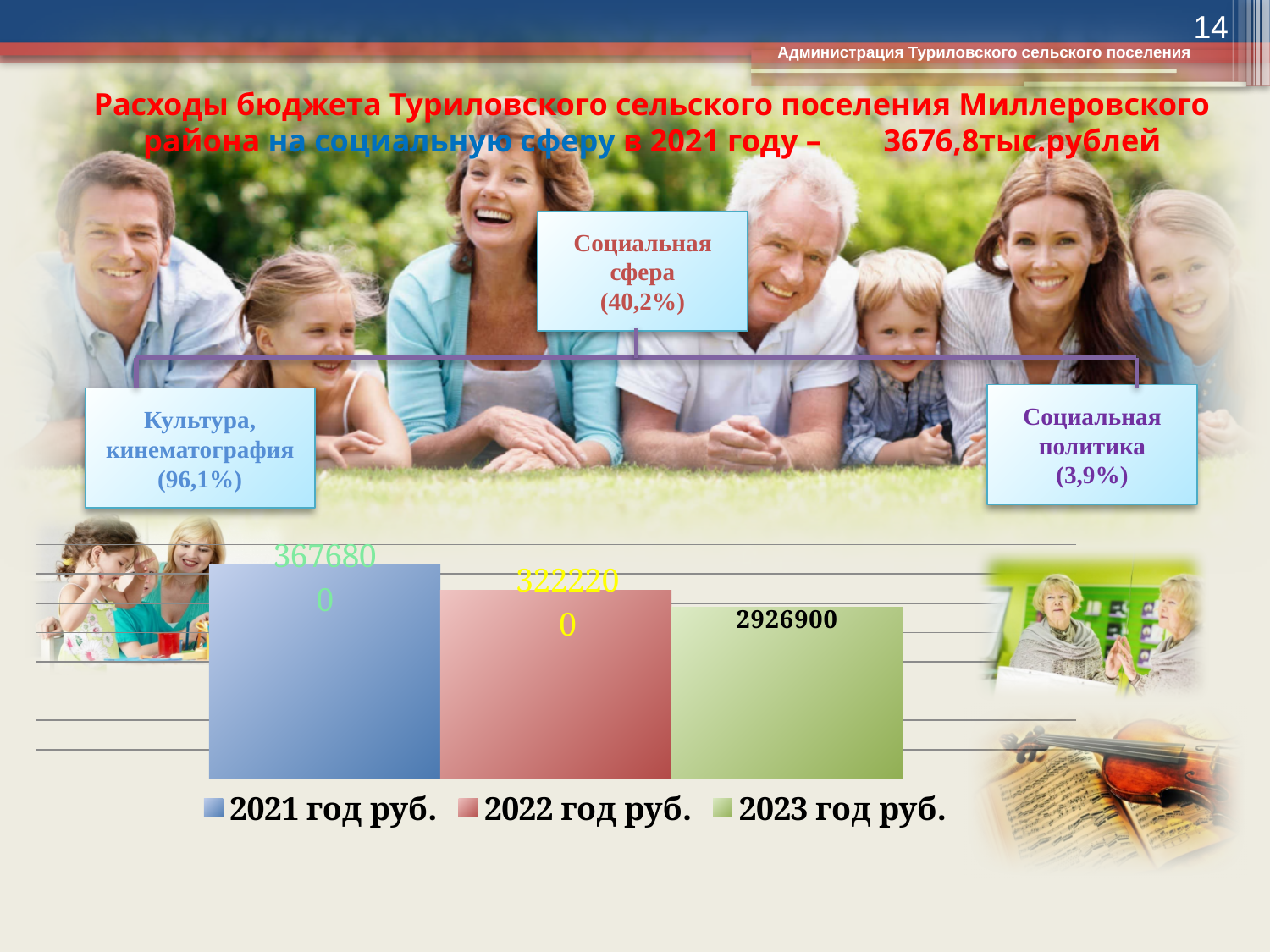
What is the difference between the values for 2021 год руб. and 2022 год руб.? 454600 Which year has the highest value in the chart? 2021 год руб. Which is larger, the value for 2022 год руб. or 2023 год руб.? 2022 год руб. What is the difference between the values for 2022 год руб. and 2023 год руб.? 295300 What kind of chart is shown on the slide? bar chart Which year has the lowest value in the chart? 2023 год руб. Do the values rise or fall from 2021 to 2023 along the chart? fall How many series does the chart legend list? 3 What is the value shown for 2023 год руб.? 2926900 What is the value shown for 2022 год руб.? 3222200 What is the value shown for 2021 год руб.? 3676800 How many bars are plotted in the chart? 3